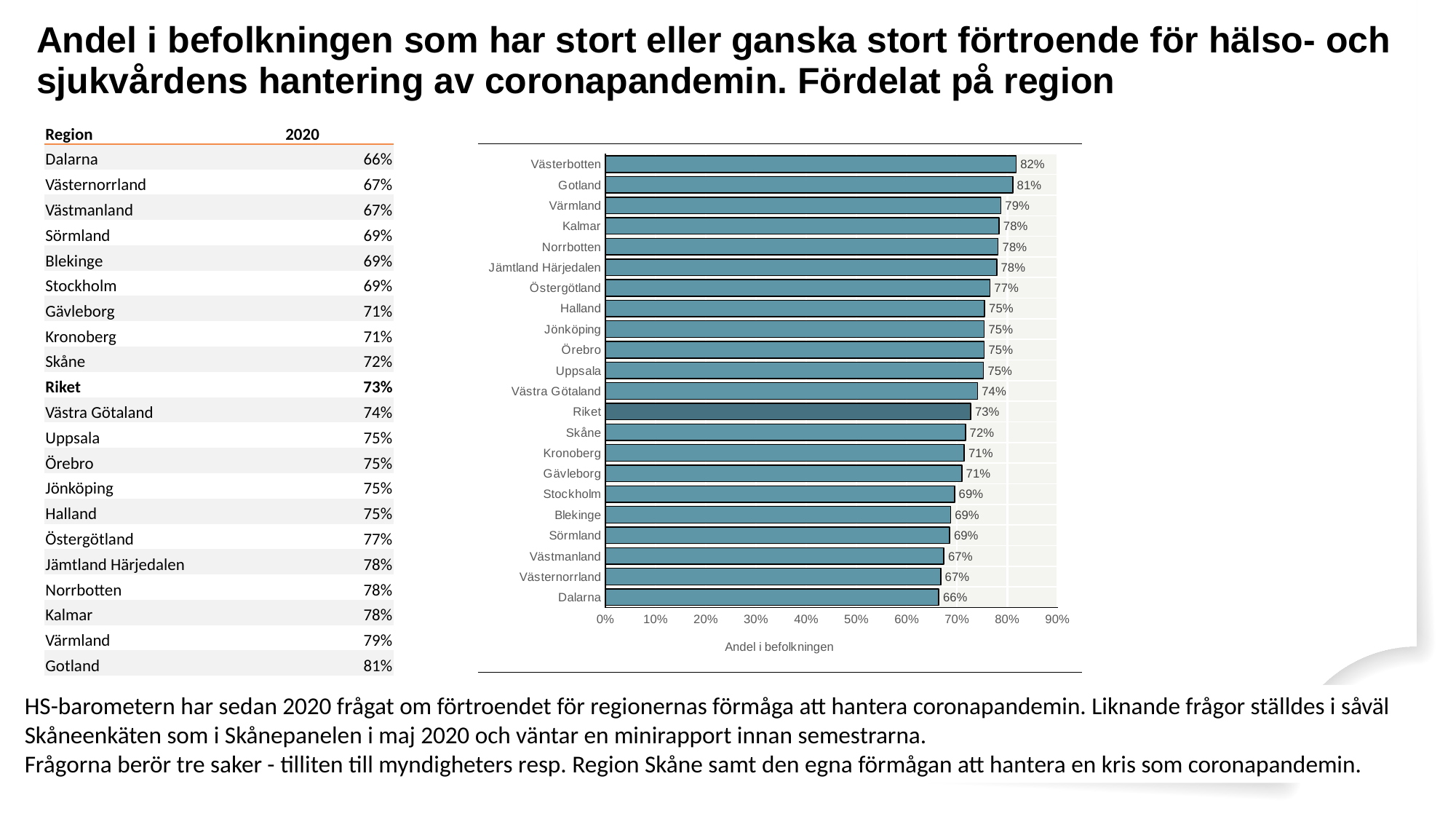
What is the value for Östergötland in the chart? 77% What is the label of the horizontal axis of the chart? Andel i befolkningen What is the difference between the values for Västerbotten and Dalarna? 16% What is the value for Riket in the chart? 73% Which has a larger value, Värmland or Skåne? Värmland What is the difference between the values for Gotland and Riket? 8% What is the value for Västerbotten in the chart? 82% How many bars are shown in the chart? 22 Which region has the highest value in the chart? Västerbotten Is the value for Stockholm greater or less than 70%? less Which region has the lowest value in the chart? Dalarna What kind of chart is shown on the slide? bar chart